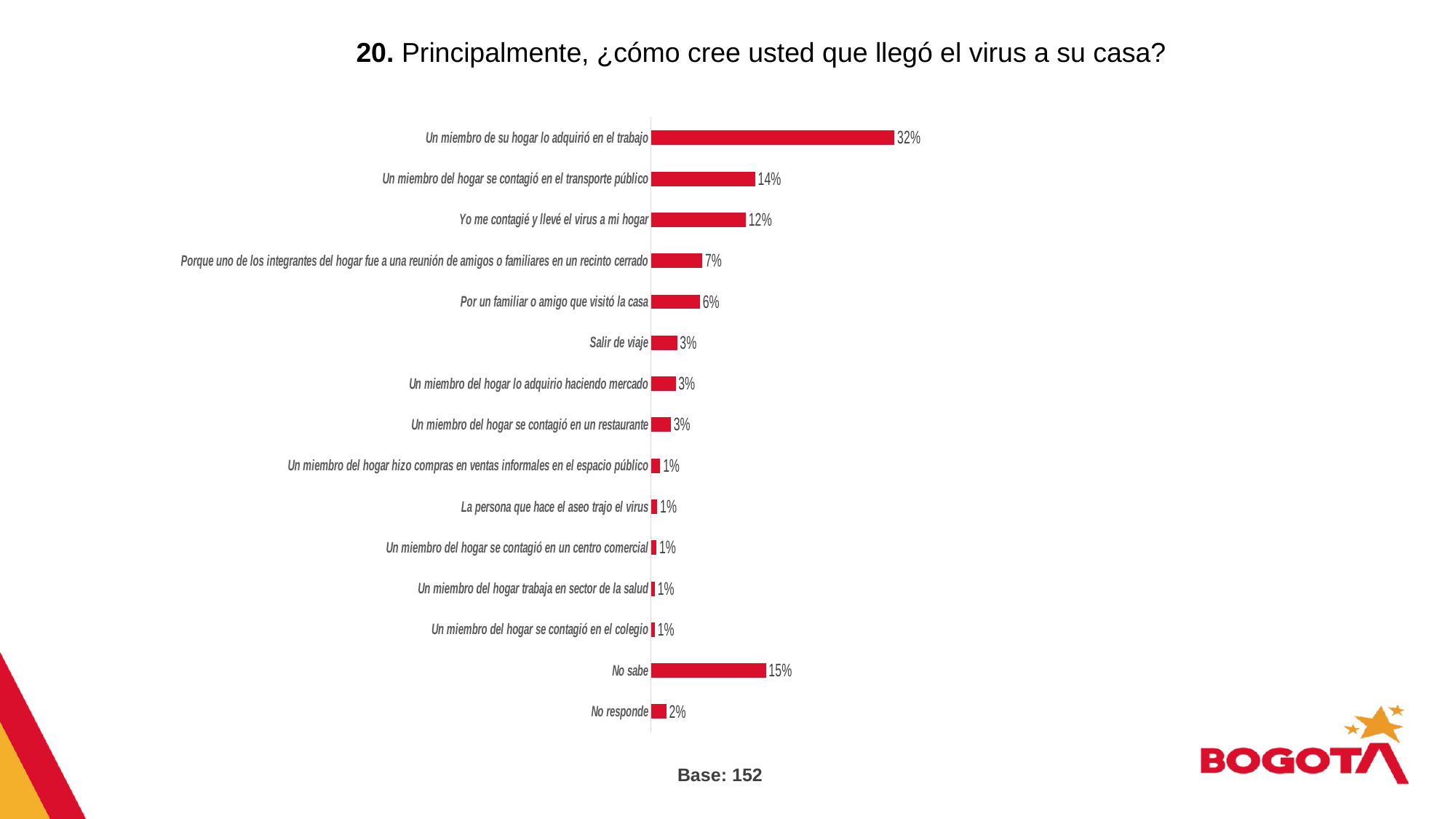
What is the difference in percentage points between "No sabe" and "Yo me contagié y llevé el virus a mi hogar"? 3 Which category has the highest percentage? Un miembro de su hogar lo adquirió en el trabajo What percentage is shown for "Por un familiar o amigo que visitó la casa"? 6% What percentage is shown for "No sabe"? 15% What is the base (number of respondents) stated below the chart? 152 What percentage is shown for "Un miembro de su hogar lo adquirió en el trabajo"? 32% How many categories are shown in the chart? 15 What type of chart is shown on the slide? Bar chart What percentage is shown for "Un miembro del hogar se contagió en el transporte público"? 14% What percentage is shown for "No responde"? 2% What is the difference in percentage points between "Un miembro de su hogar lo adquirió en el trabajo" and "Un miembro del hogar se contagió en el transporte público"? 18 Which is larger: the value for "No sabe" or the value for "Un miembro del hogar se contagió en el transporte público"? No sabe